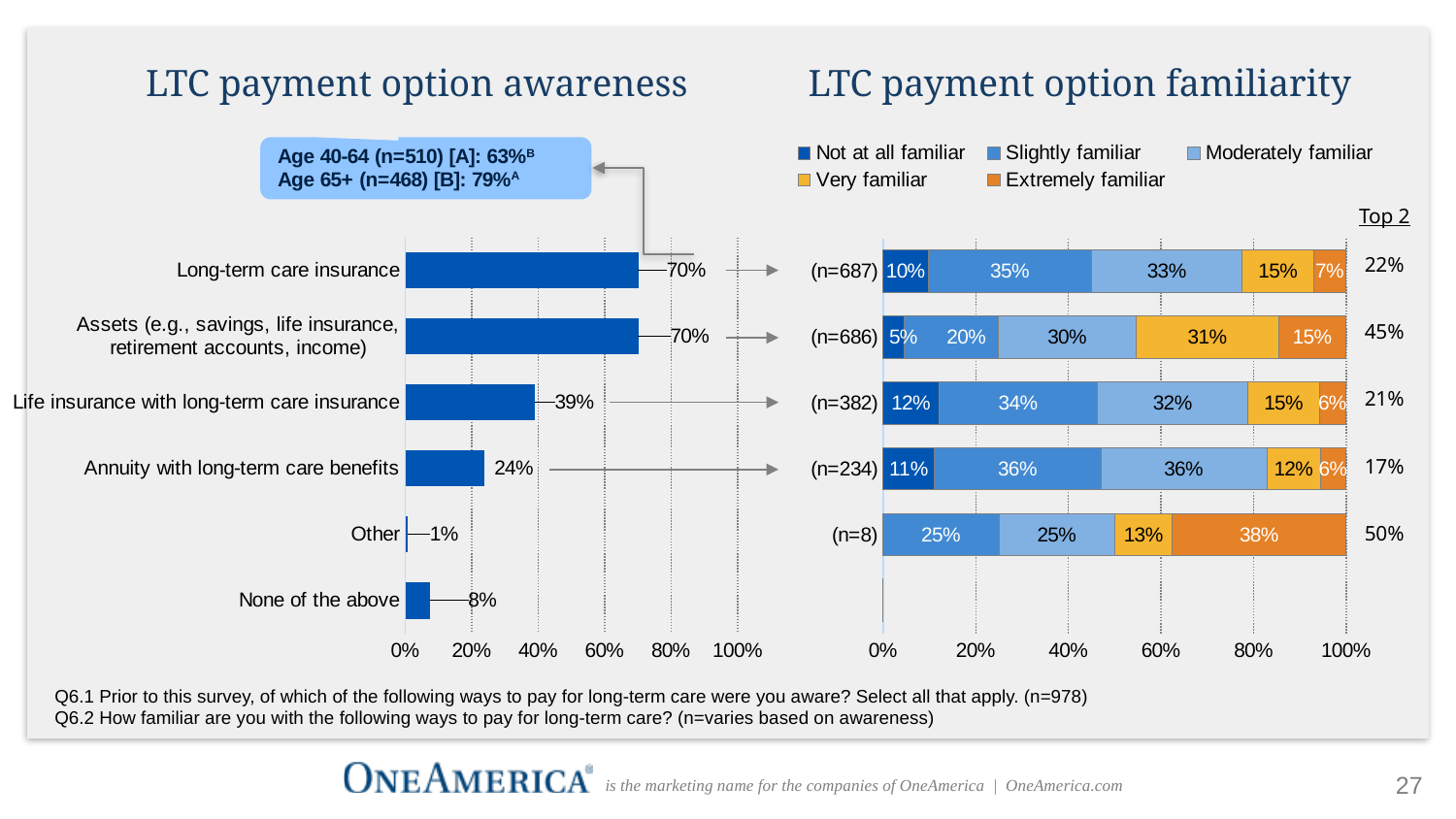
In the LTC payment option familiarity chart, what is the Extremely familiar value for the (n=8) bar? 38% In the LTC payment option awareness chart, what is the difference between Life insurance with long-term care insurance and Annuity with long-term care benefits? 15% In the LTC payment option familiarity chart, which legend entry is shown in the darkest blue? Not at all familiar In the LTC payment option familiarity chart, what is the Very familiar value for the (n=686) bar? 31% In the LTC payment option familiarity chart, what is the Top 2 value for the (n=687) bar? 22% In the LTC payment option awareness chart, which is larger: None of the above or Other? None of the above In the LTC payment option awareness chart, which category has the lowest value? Other In the LTC payment option awareness chart, what is the value for Life insurance with long-term care insurance? 39% What kind of chart is the LTC payment option awareness chart? Bar chart How many categories are shown in the LTC payment option awareness chart? 6 How many series does the legend of the LTC payment option familiarity chart list? 5 In the LTC payment option awareness chart, what is the value for Annuity with long-term care benefits? 24%